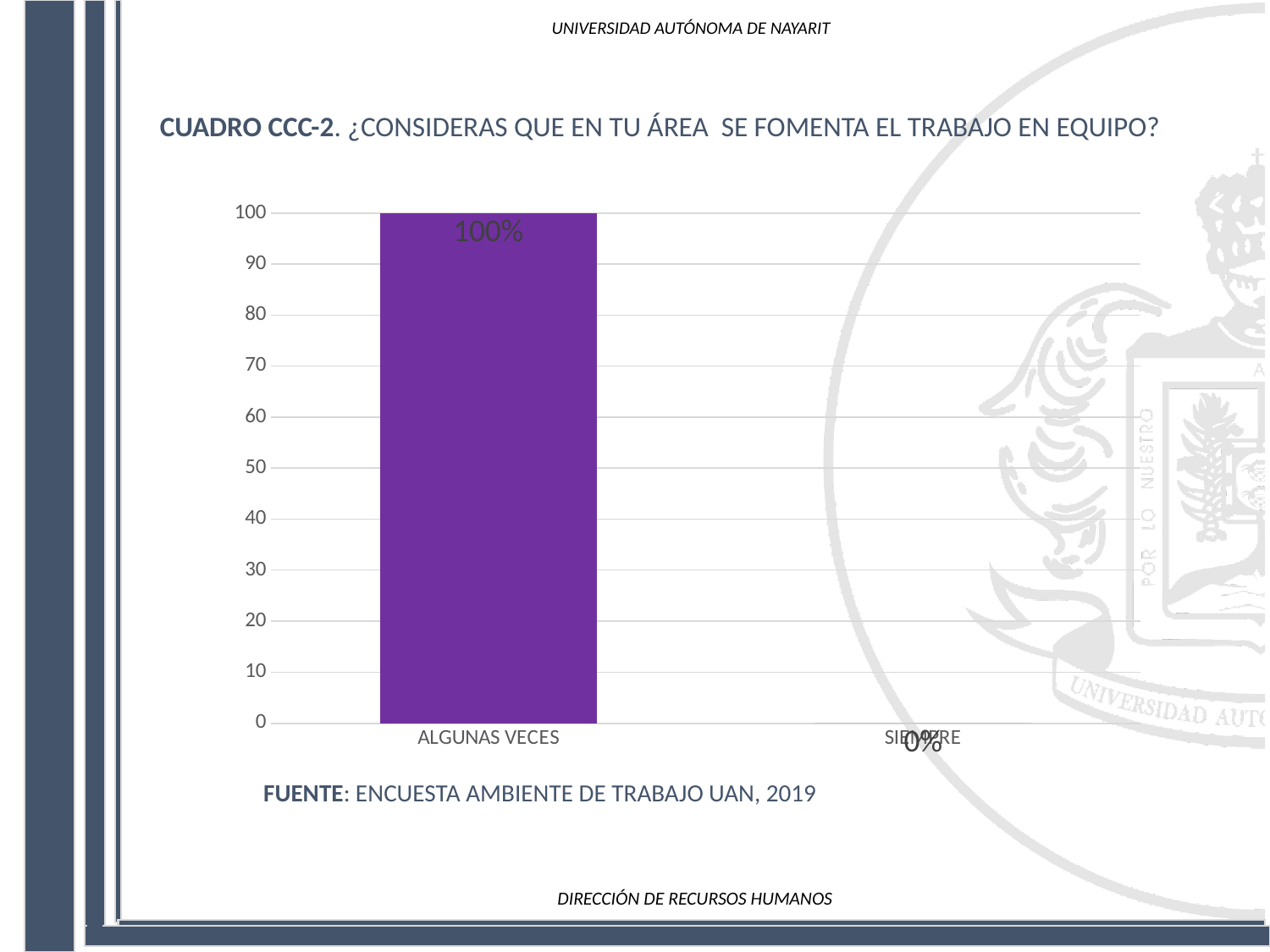
What is the highest tick value shown on the vertical axis? 100 How many categories are shown on the x axis? 2 What source is cited below the chart? ENCUESTA AMBIENTE DE TRABAJO UAN, 2019 Which category has the lowest value? SIEMPRE Which is larger, the value for ALGUNAS VECES or the value for SIEMPRE? ALGUNAS VECES Is the value for ALGUNAS VECES greater or less than 50? greater What kind of chart is shown on the slide? bar chart What is the value for ALGUNAS VECES? 100% What is the difference between the values for ALGUNAS VECES and SIEMPRE? 100% Do the values rise or fall from ALGUNAS VECES to SIEMPRE? fall Which category has the highest value? ALGUNAS VECES What is the value for SIEMPRE? 0%